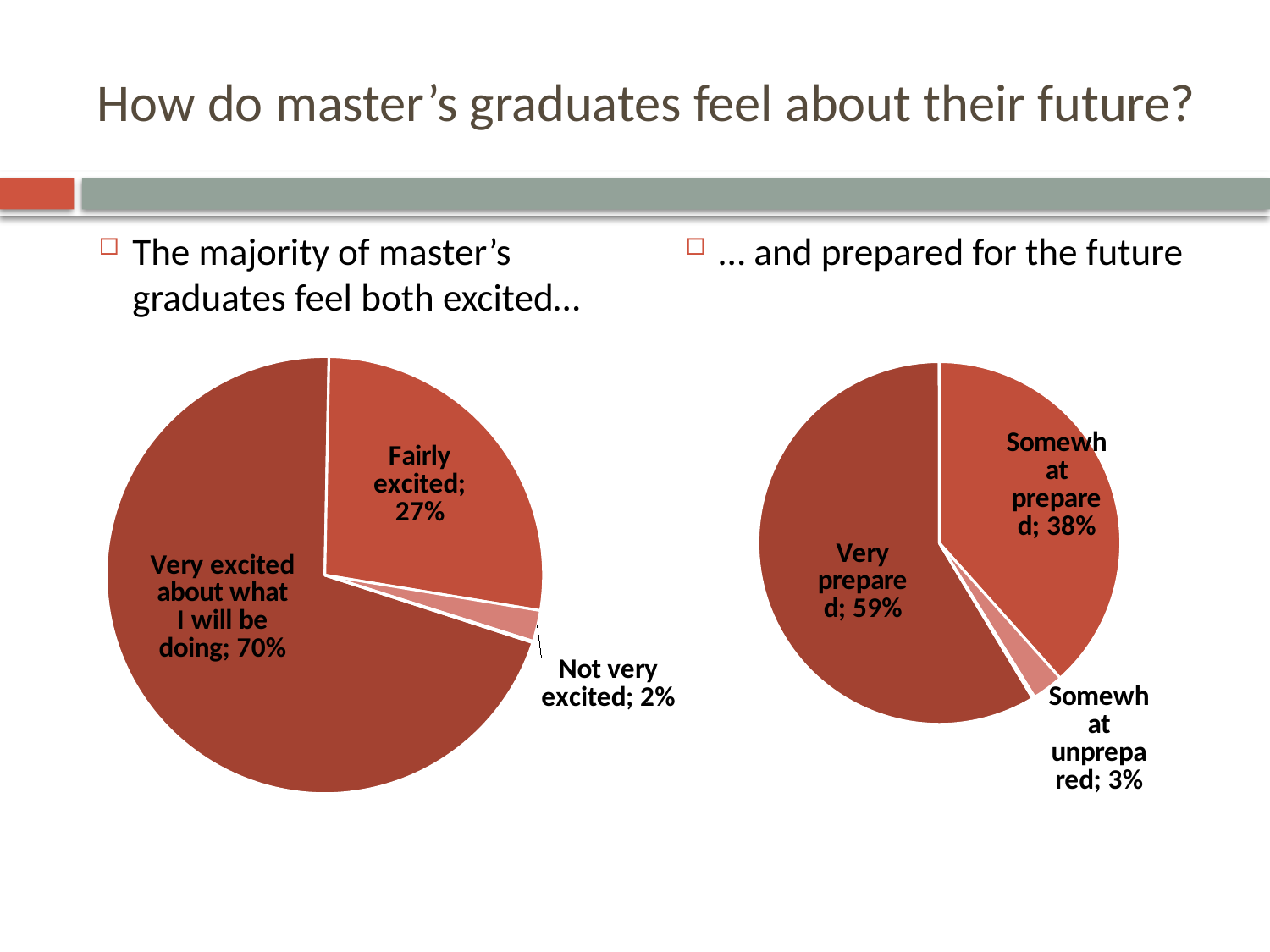
In the left pie chart, what percentage are not very excited? 2% In the right pie chart, which is larger: very prepared or somewhat prepared? Very prepared In the right pie chart, what percentage feel somewhat unprepared? 3% In the left pie chart, what share of master's graduates are very excited about what they will be doing? 70% In the left pie chart, what is the difference in percentage points between very excited and fairly excited? 43 In the left pie chart, what percentage are fairly excited? 27% In the right pie chart, which category has the smallest share? Somewhat unprepared In the left pie chart, which category has the largest share? Very excited about what I will be doing In the right pie chart, what percentage feel very prepared? 59% In the right pie chart, what percentage feel somewhat prepared? 38% What type of chart is shown on the left of the slide? Pie chart How many slices does the right pie chart have? 3